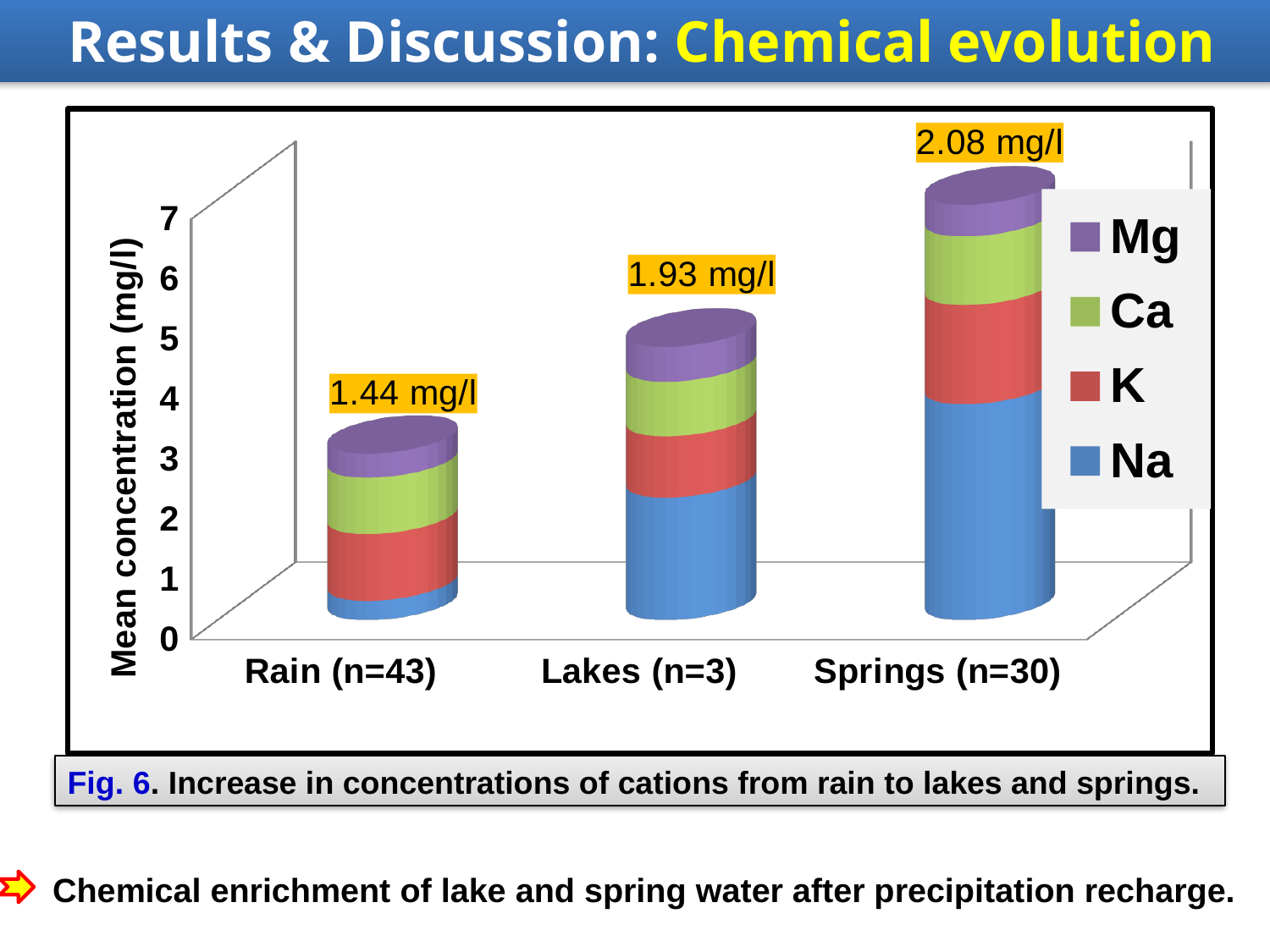
Is the Na segment of the Rain (n=43) bar greater or less than 1? less What value is printed above the Lakes (n=3) bar? 1.93 mg/l What is the title of the y axis of the chart? Mean concentration (mg/l) How many series does the chart's legend list? 4 What value is printed above the Rain (n=43) bar? 1.44 mg/l How many categories are shown on the x axis of the chart? 3 Which category has the tallest stacked bar? Springs (n=30) Is the total height of the Springs (n=30) stacked bar greater or less than 6? greater Do the stacked bar heights rise or fall from Rain to Springs along the x axis? rise What value is printed above the Springs (n=30) bar? 2.08 mg/l What kind of chart is shown on the slide? bar chart Which category has the shortest stacked bar? Rain (n=43)